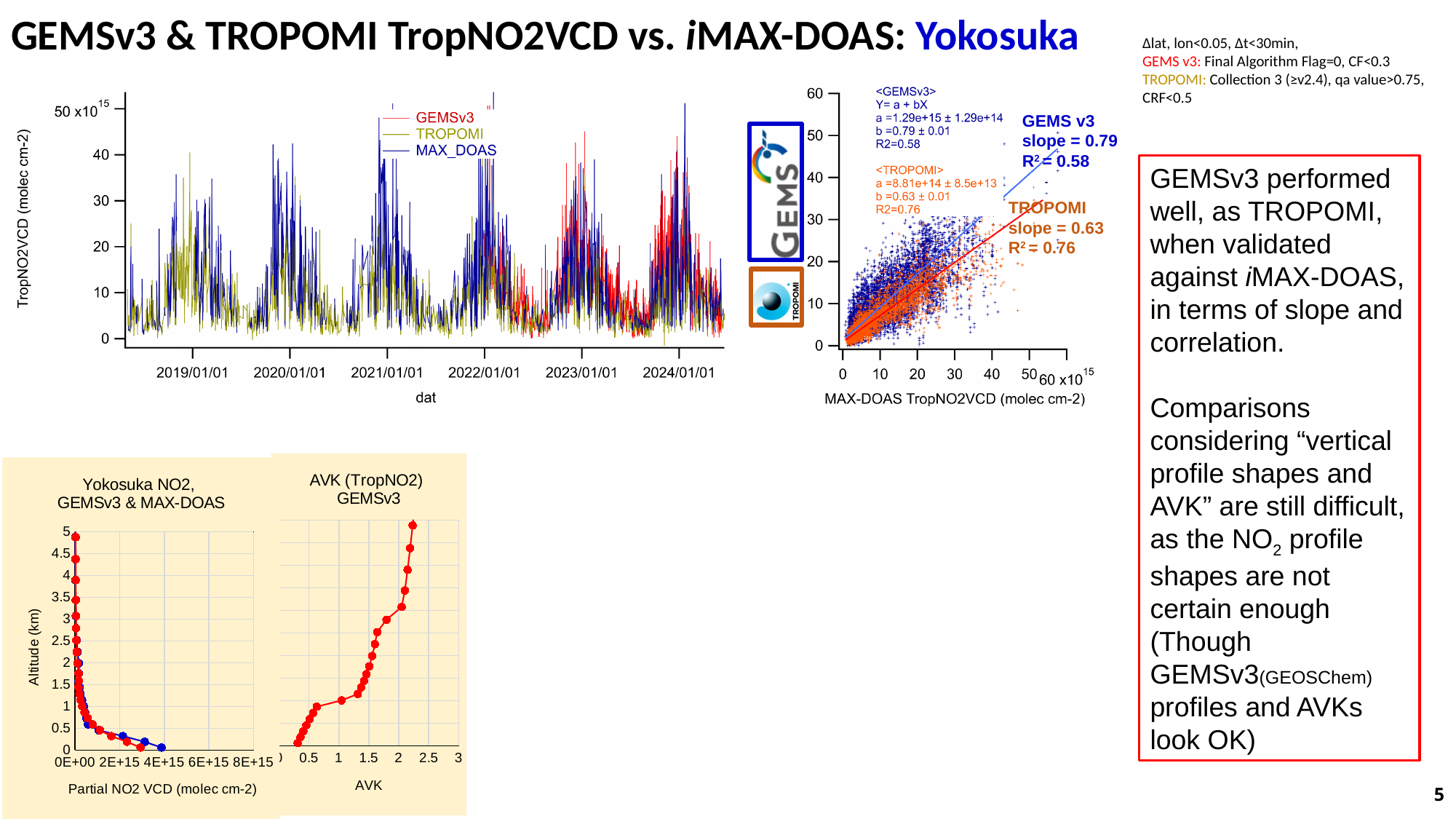
In the bottom-left chart titled 'Yokosuka NO2, GEMSv3 & MAX-DOAS', is the red series value at 0 km altitude greater or less than 4E+15? less In the top-middle scatter plot, which has the larger slope, GEMS v3 or TROPOMI? GEMS v3 In the top-left time series chart, how many series does the legend list? 3 In the chart titled 'AVK (TropNO2) GEMSv3', is the AVK value at 5 km altitude greater or less than 2? greater In the bottom-left chart titled 'Yokosuka NO2, GEMSv3 & MAX-DOAS', does the partial NO2 VCD increase or decrease as altitude increases? decrease In the top-middle scatter plot, what is the slope for GEMS v3? 0.79 What kind of chart is the top-left chart plotting TropNO2VCD against date? line chart In the top-left time series chart, what are the three series named in the legend? GEMSv3, TROPOMI, MAX_DOAS In the top-middle scatter plot, what is the R² value for TROPOMI? 0.76 In the top-middle scatter plot, which has the higher R², GEMS v3 or TROPOMI? TROPOMI What kind of chart is the top-middle chart comparing satellite TropNO2VCD with MAX-DOAS TropNO2VCD? scatter plot In the top-middle scatter plot, what is the difference between the GEMS v3 slope and the TROPOMI slope? 0.16